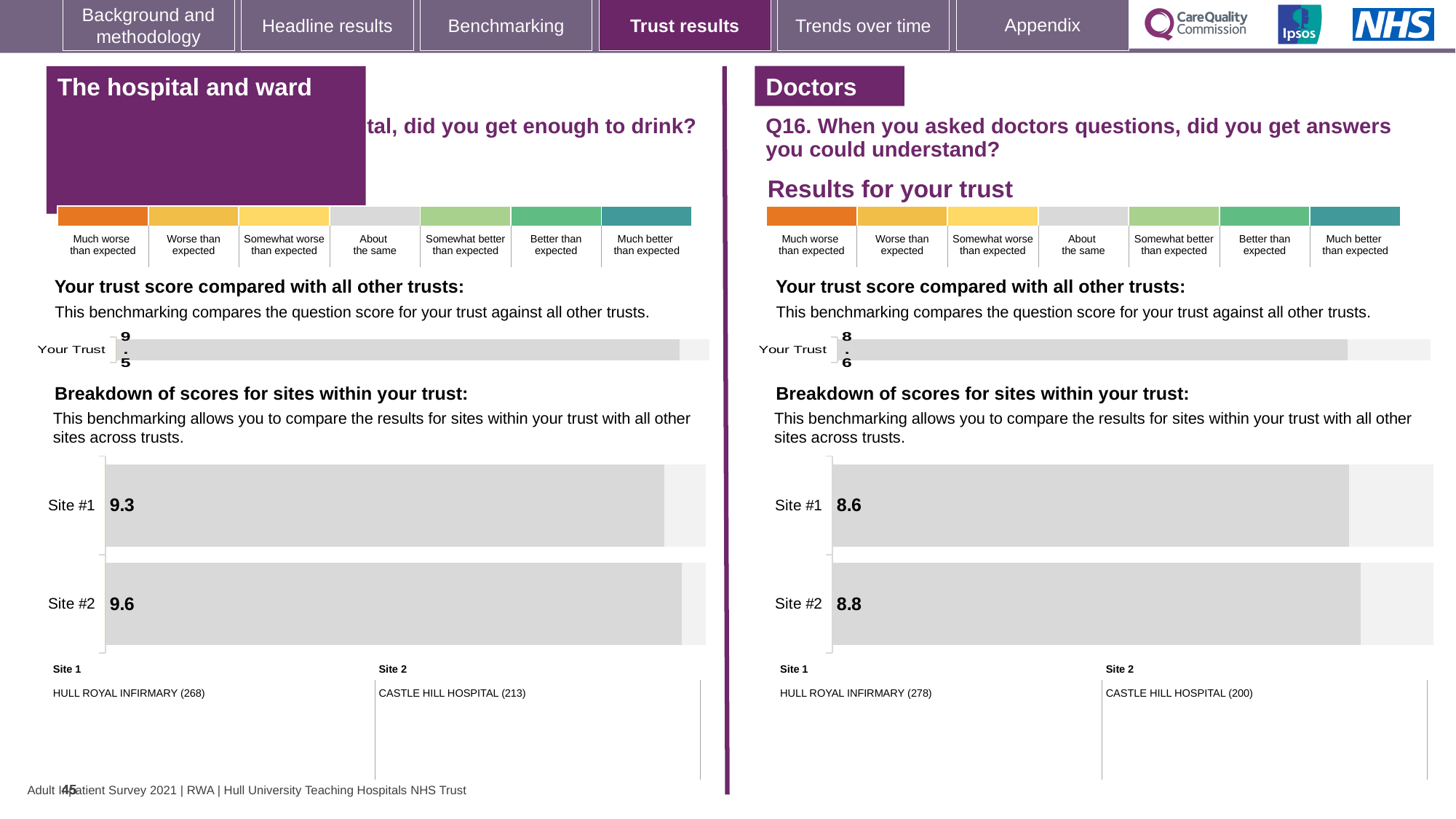
What type of chart is used for the Q16 site breakdown on the right? Bar chart In the Q16 'Breakdown of scores for sites within your trust' chart on the right, what is the score for Site #1? 8.6 In the left-hand 'Breakdown of scores for sites within your trust' chart, what is the score for Site #2? 9.6 In the left-hand 'Your trust score compared with all other trusts' chart, what is the score for Your Trust? 9.5 In the left-hand site breakdown chart, which site has the higher score? Site #2 In the left-hand site breakdown chart, what is the difference between the Site #2 and Site #1 scores? 0.3 How many sites are shown in the left-hand site breakdown chart? 2 In the Q16 'Your trust score compared with all other trusts' chart on the right, what is the score for Your Trust? 8.6 In the Q16 site breakdown chart on the right, what is the difference between the Site #2 and Site #1 scores? 0.2 In the Q16 'Breakdown of scores for sites within your trust' chart on the right, what is the score for Site #2? 8.8 In the Q16 site breakdown chart on the right, which site has the lower score? Site #1 In the left-hand 'Breakdown of scores for sites within your trust' chart, what is the score for Site #1? 9.3